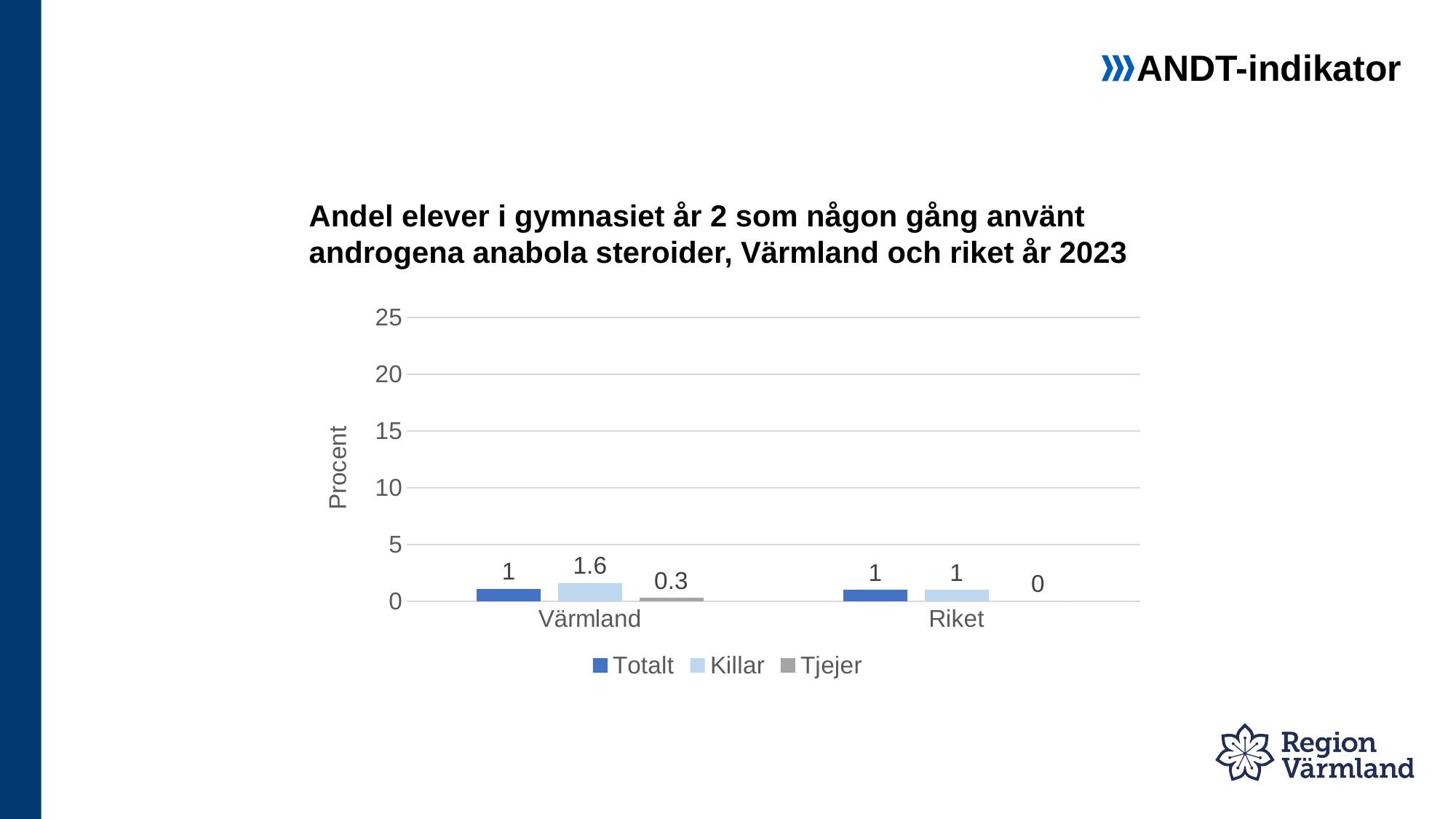
Which is larger: Tjejer in Värmland or Tjejer in Riket? Tjejer in Värmland How many categories are shown on the x axis? 2 What is the value for Tjejer in Värmland? 0.3 Which series has the lowest value in Riket? Tjejer What is the value for Killar in Värmland? 1.6 What kind of chart is shown on the slide? bar chart How many series does the legend list? 3 Which series has the highest value in Värmland? Killar Is the value for Killar in Värmland greater or less than 5? less What is the value for Tjejer in Riket? 0 What is the difference between the Killar value in Värmland and the Killar value in Riket? 0.6 What is the value for Totalt in Riket? 1